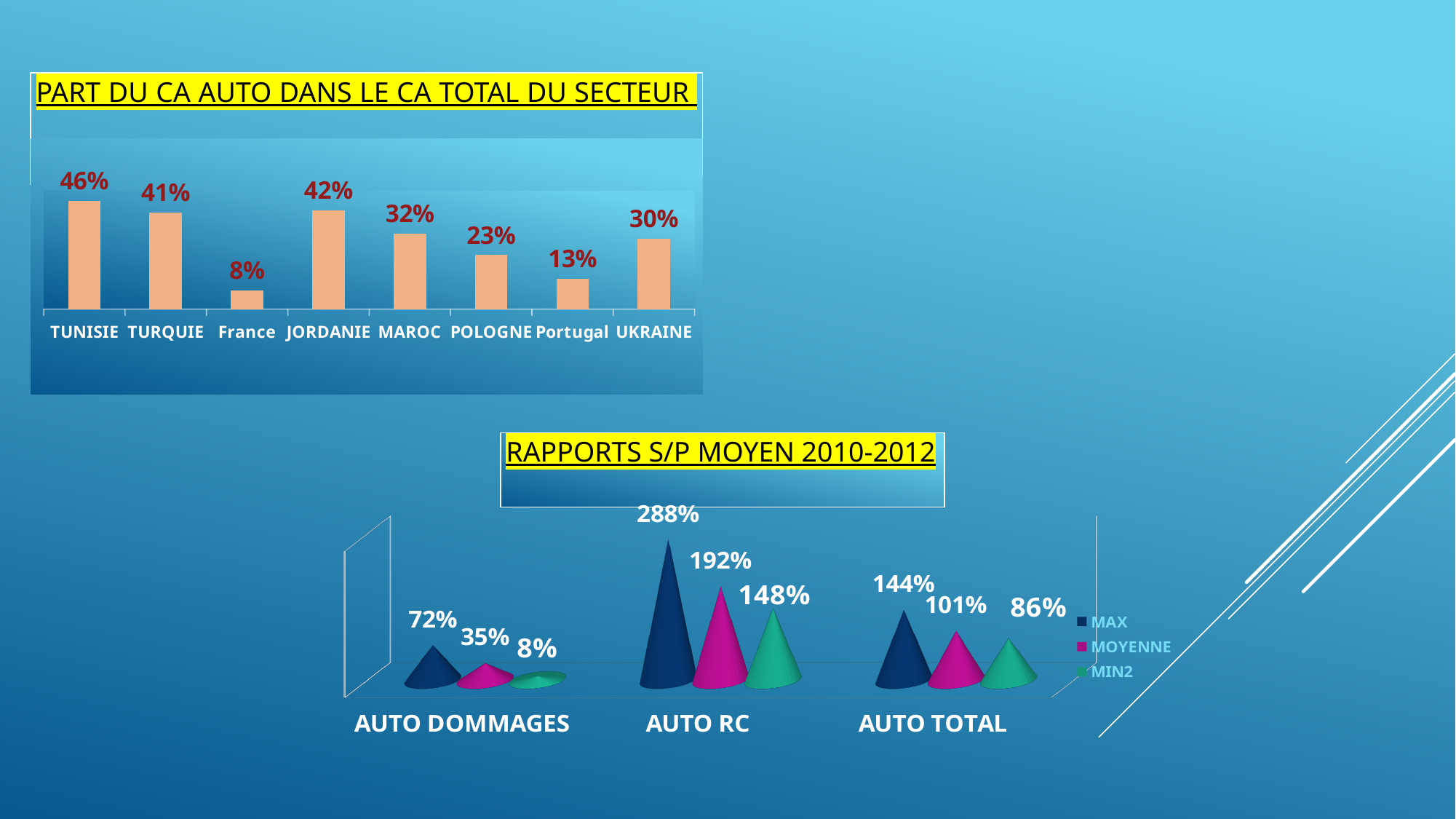
In the chart 'PART DU CA AUTO DANS LE CA TOTAL DU SECTEUR', which is larger, the value for JORDANIE or the value for TURQUIE? JORDANIE How many series does the legend of the chart 'RAPPORTS S/P MOYEN 2010-2012' list? 3 In the chart 'RAPPORTS S/P MOYEN 2010-2012', which category has the highest MAX value? AUTO RC What kind of chart is 'PART DU CA AUTO DANS LE CA TOTAL DU SECTEUR'? Bar chart In the chart 'RAPPORTS S/P MOYEN 2010-2012', what is the MOYENNE value for AUTO TOTAL? 101% In the chart 'PART DU CA AUTO DANS LE CA TOTAL DU SECTEUR', what is the value for MAROC? 32% In the chart 'RAPPORTS S/P MOYEN 2010-2012', what is the difference between the MAX and MIN2 values for AUTO DOMMAGES? 64% In the chart 'PART DU CA AUTO DANS LE CA TOTAL DU SECTEUR', which country has the lowest value? France In the chart 'RAPPORTS S/P MOYEN 2010-2012', what is the MAX value for AUTO RC? 288% How many countries are shown in the chart 'PART DU CA AUTO DANS LE CA TOTAL DU SECTEUR'? 8 In the chart 'PART DU CA AUTO DANS LE CA TOTAL DU SECTEUR', which country has the highest value? TUNISIE In the chart 'PART DU CA AUTO DANS LE CA TOTAL DU SECTEUR', what is the difference between the values for TUNISIE and UKRAINE? 16%